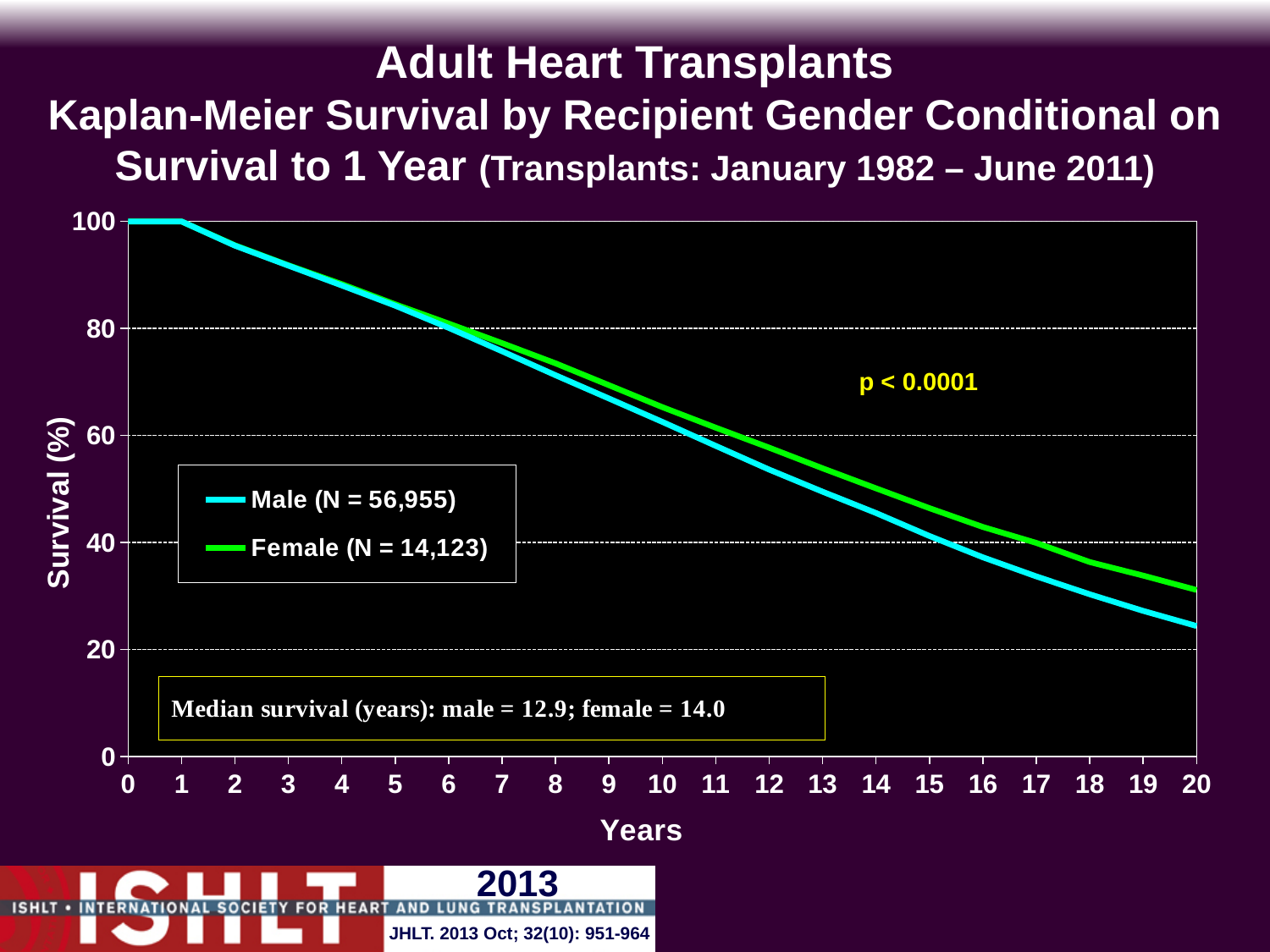
What is the median survival in years for female recipients? 14.0 How many series does the legend list? 2 Do the survival curves rise or fall as years increase? fall What is the difference in median survival (years) between female and male recipients? 1.1 Is the survival value for male recipients at 20 years greater or less than 40? less What is the number of male recipients (N) shown in the legend? 56,955 Which group has the higher median survival, male or female recipients? Female Is the survival value for female recipients at 5 years greater or less than 80? greater What p-value is shown on the chart? p < 0.0001 What is the number of female recipients (N) shown in the legend? 14,123 What is the median survival in years for male recipients? 12.9 What type of chart is shown on the slide? line chart